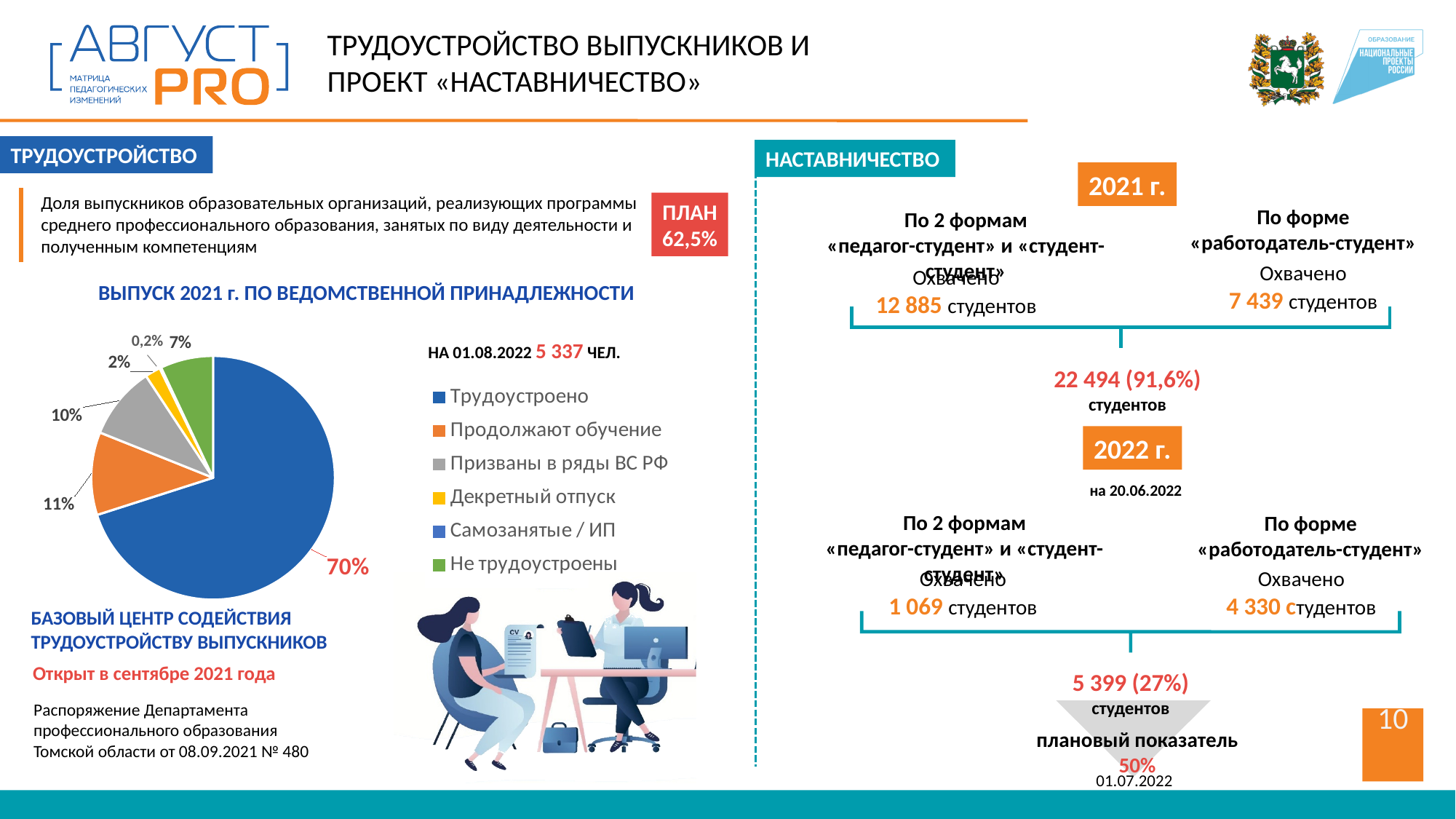
In the pie chart, what share is labelled for «Призваны в ряды ВС РФ»? 10% In the pie chart, which is larger: «Продолжают обучение» or «Не трудоустроены»? Продолжают обучение Which category has the smallest slice in the pie chart? Самозанятые / ИП In the pie chart, what share is labelled for «Самозанятые / ИП»? 0,2% In the pie chart, what share is labelled for «Не трудоустроены»? 7% What kind of chart is shown under the title «ВЫПУСК 2021 г. ПО ВЕДОМСТВЕННОЙ ПРИНАДЛЕЖНОСТИ»? Pie chart Which category has the largest slice in the pie chart? Трудоустроено How many categories does the pie chart legend list? 6 In the pie chart, what share is labelled for «Трудоустроено»? 70% What colour is the «Декретный отпуск» slice in the pie chart? Yellow In the pie chart, what share is labelled for «Продолжают обучение»? 11% What is the difference in percentage points between «Трудоустроено» and «Продолжают обучение» in the pie chart? 59